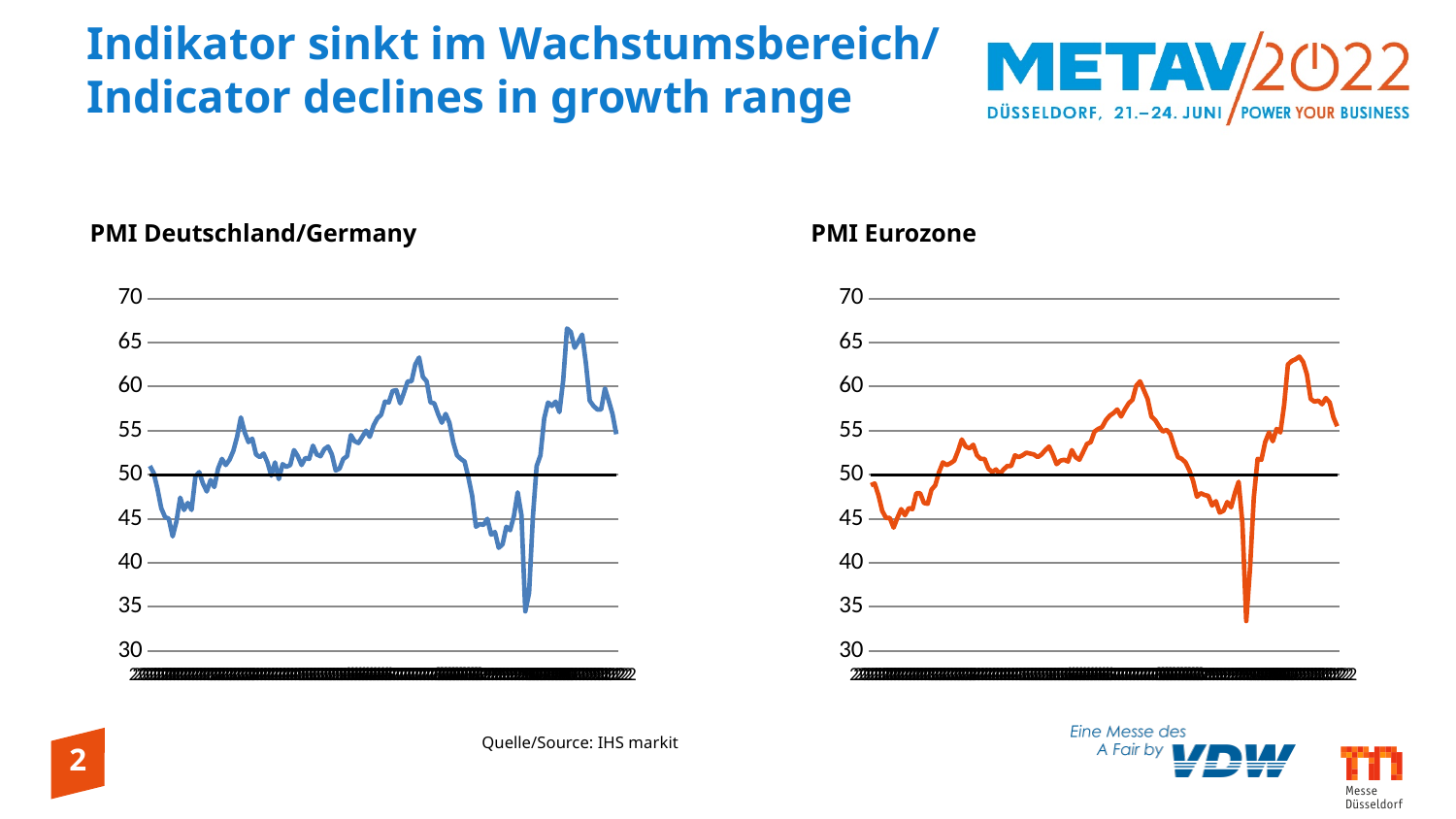
In the PMI Deutschland/Germany chart, is the lowest value of the line greater or less than 40? less In the PMI Eurozone chart, is the highest value of the line greater or less than 60? greater At which value is the bold horizontal reference line drawn in both charts? 50 What colour is the line in the PMI Eurozone chart? orange In the PMI Deutschland/Germany chart, is the highest value of the line greater or less than 60? greater What kind of chart is the PMI Deutschland/Germany chart? line chart What kind of chart is the PMI Eurozone chart? line chart Which chart reaches the higher peak value, PMI Deutschland/Germany or PMI Eurozone? PMI Deutschland/Germany